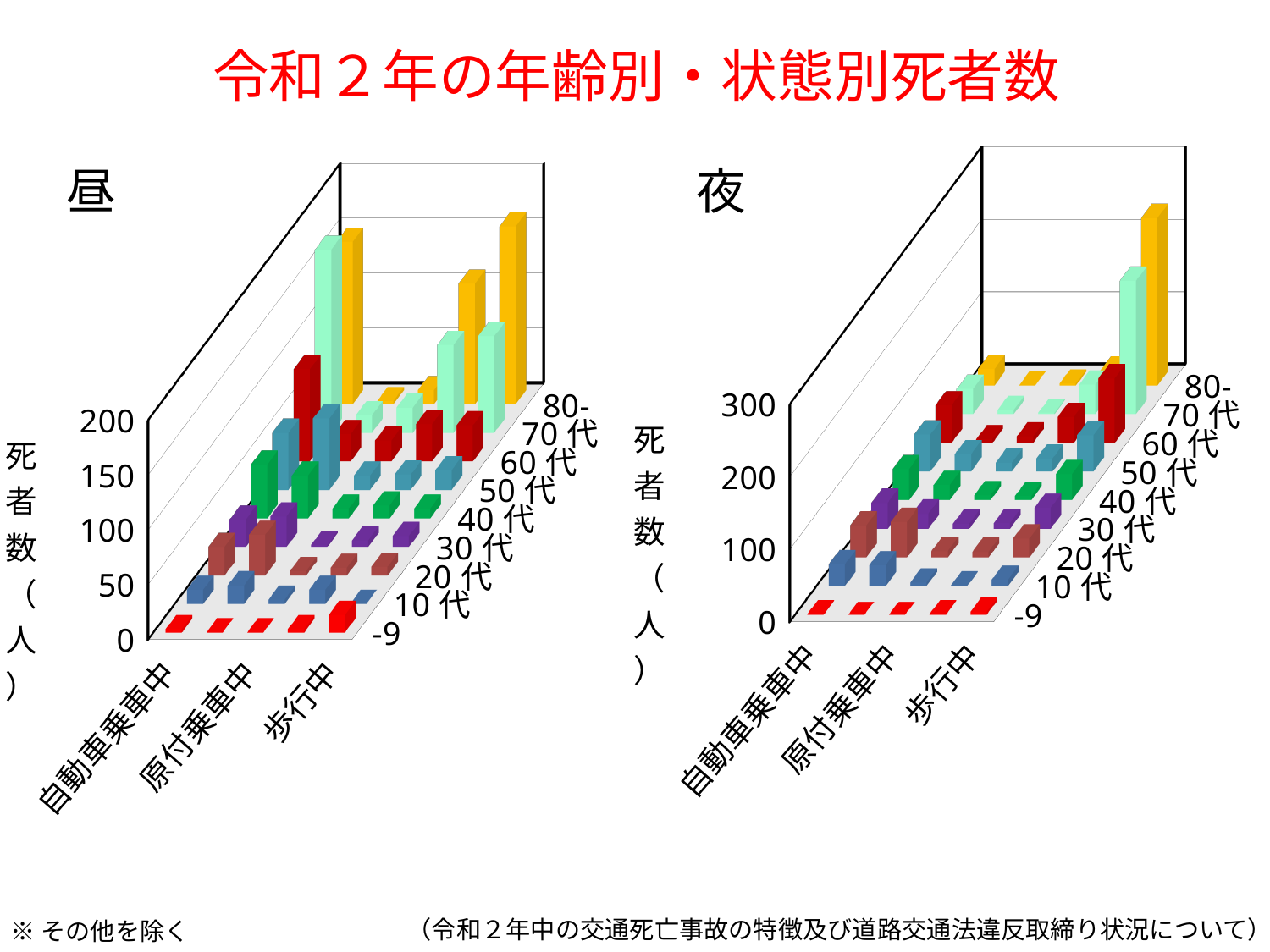
What kind of chart is the 昼 chart? bar chart How many age groups are shown along the depth axis of the 夜 chart? 9 In the 夜 chart, is the value for 自動車乗車中 in the -9 age group greater or less than 100? less In the 昼 chart, is the value for 歩行中 in the -9 age group greater or less than 50? less In the 夜 chart, which age group has the tallest bar for 歩行中? 80- What is the highest tick value on the vertical axis of the 夜 chart? 300 In the 夜 chart, is the value for 歩行中 in the 80- age group greater or less than 100? greater In the 夜 chart, which is larger for 歩行中: the 80- age group or the 20代 age group? 80- In the 昼 chart, which age group has the tallest bar for 歩行中? 80- In the 昼 chart, which is larger for 歩行中: the 80- age group or the 10代 age group? 80- What is the title of the slide containing the two charts? 令和2年の年齢別・状態別死者数